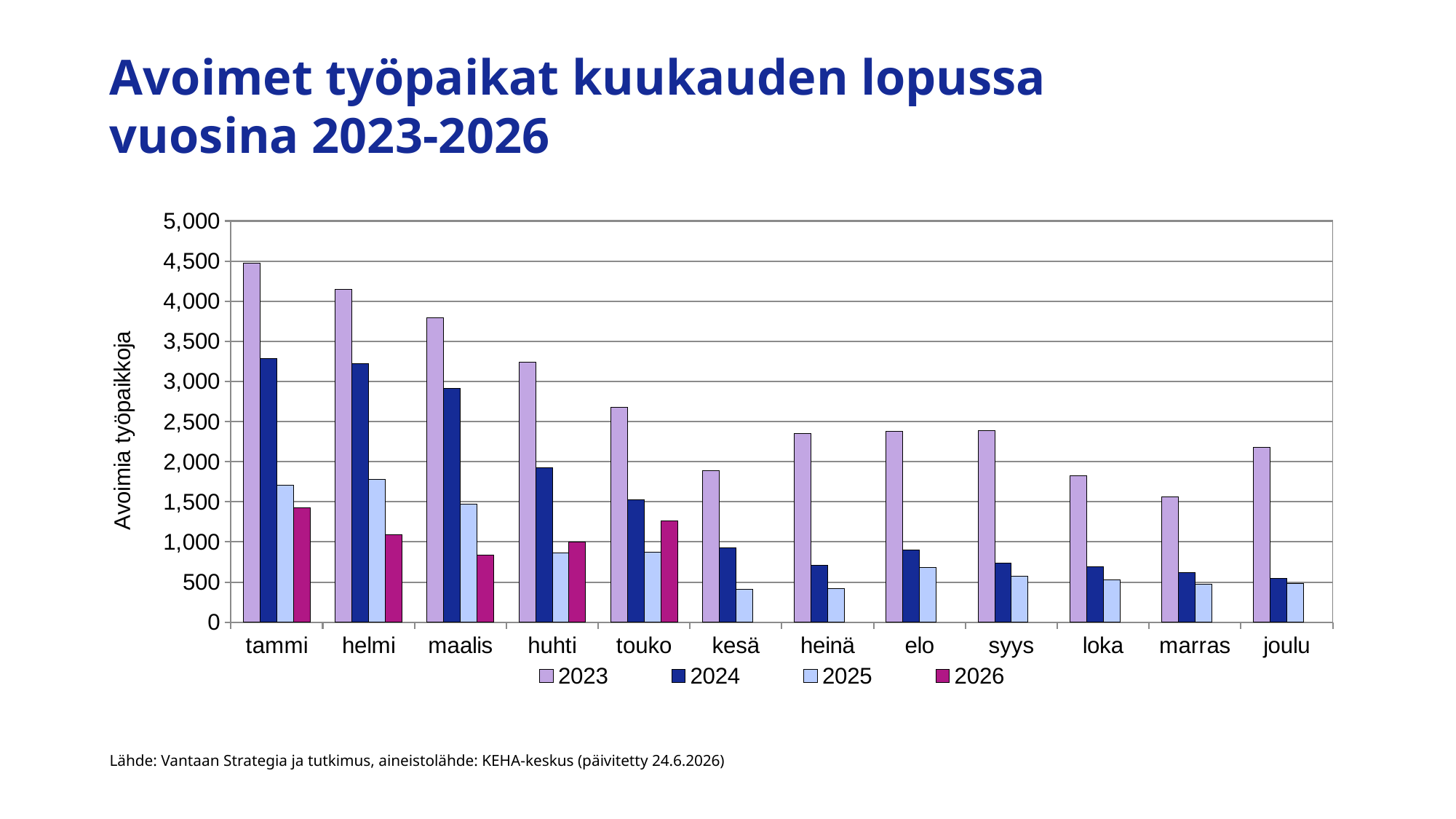
Which month has the lowest value for 2026? maalis Is the value for 2023 in tammi greater or less than 4,000? greater What kind of chart is shown on the slide? bar chart In tammi, which is larger: the value for 2024 or the value for 2025? 2024 Which month has the lowest value for 2023? marras Is the value for 2024 in huhti greater or less than 2,000? less How many series does the legend list? 4 Which month has the highest value for 2026? tammi Which month has the highest value for 2023? tammi How many months are shown on the x axis? 12 For how many months is a 2026 bar plotted? 5 Do the values for 2024 generally rise or fall from tammi to joulu? fall